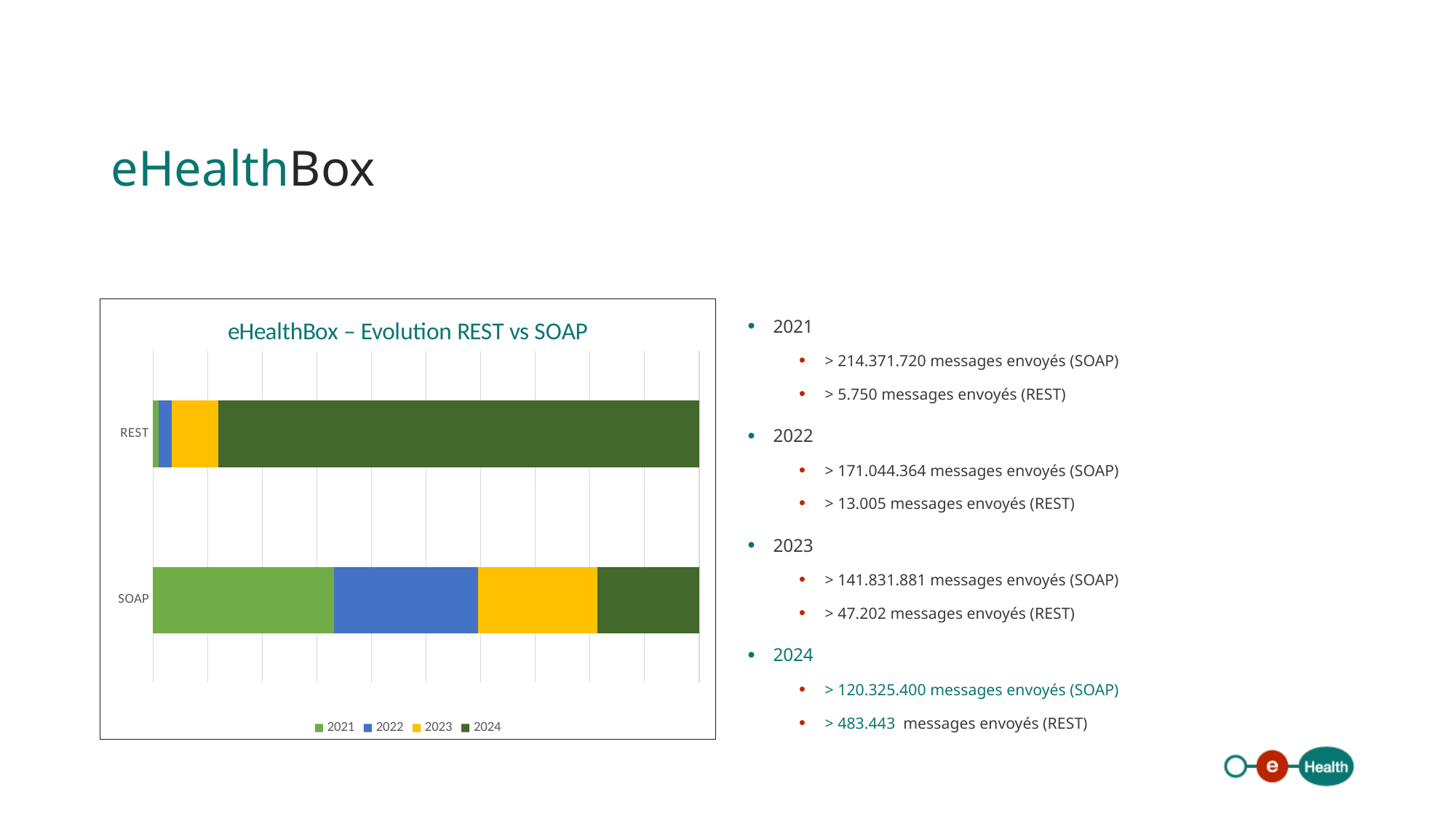
How many series does the chart legend list? 4 In the REST bar, which year's segment is the largest? 2024 Which entries appear in the chart legend? 2021, 2022, 2023, 2024 What kind of chart is shown on the slide? bar chart In the REST bar, which year's segment is the smallest? 2021 How many categories are plotted on the vertical axis of the chart? 2 In the REST bar, which segment is larger, 2022 or 2023? 2023 In the SOAP bar, which year's segment is the smallest? 2024 In the SOAP bar, which year's segment is the largest? 2021 In the SOAP bar, do the segment widths increase or decrease from 2021 to 2024? decrease In the SOAP bar, which segment is larger, 2021 or 2024? 2021 What is the title of the chart? eHealthBox – Evolution REST vs SOAP